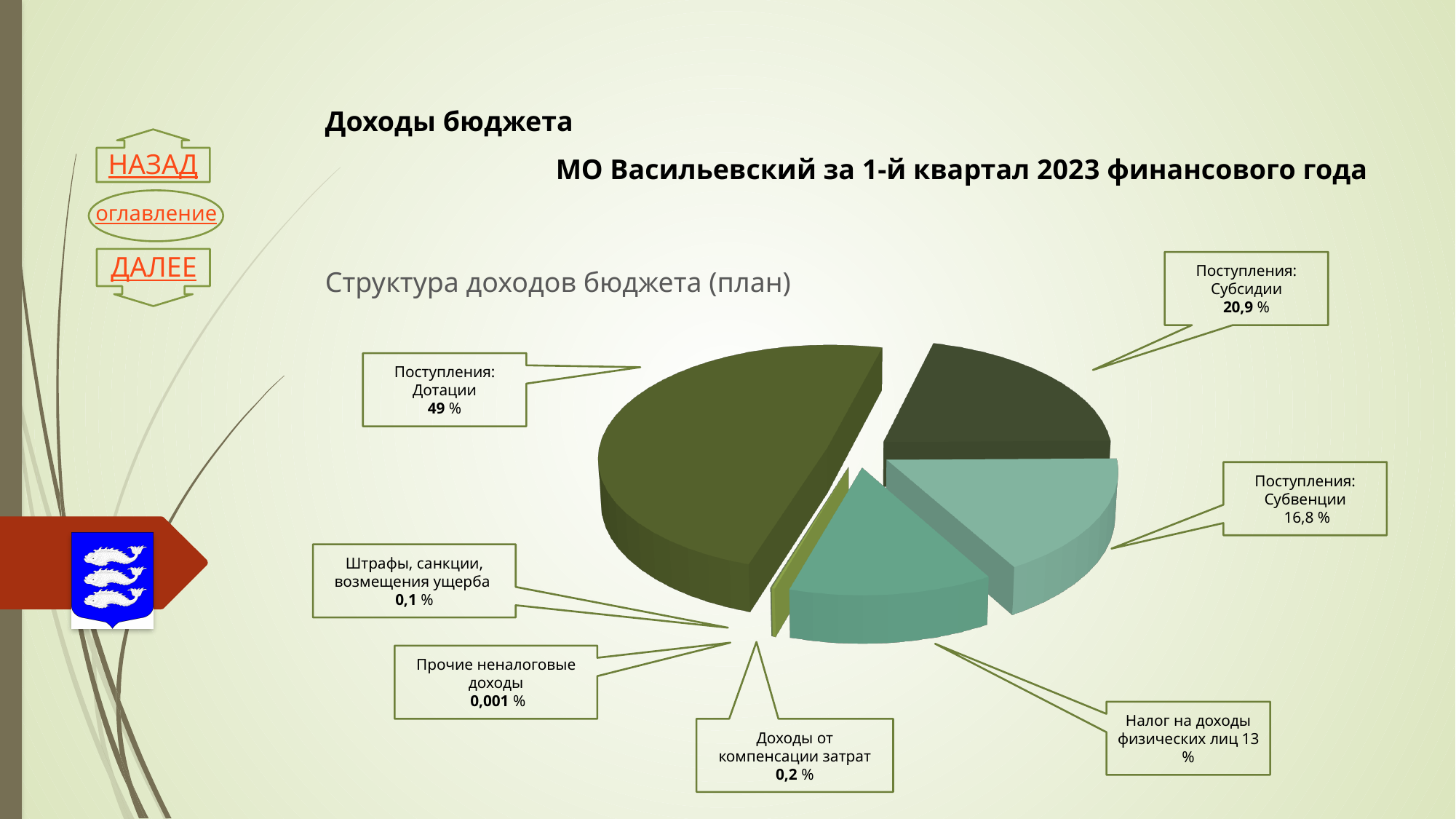
How many categories are labelled on the pie chart? 7 What share is shown for Прочие неналоговые доходы? 0,001 % What share of the pie is labelled for Поступления: Дотации? 49 % What is the title of the chart? Структура доходов бюджета (план) What share is shown for Доходы от компенсации затрат? 0,2 % What kind of chart is shown on the slide? pie chart What share is shown for Поступления: Субвенции? 16,8 % Which category has the smallest share of the pie? Прочие неналоговые доходы What share is shown for Поступления: Субсидии? 20,9 % Which is larger, the share for Субсидии or the share for Субвенции? Субсидии What share is shown for Налог на доходы физических лиц? 13 % Which category has the largest share of the pie? Поступления: Дотации